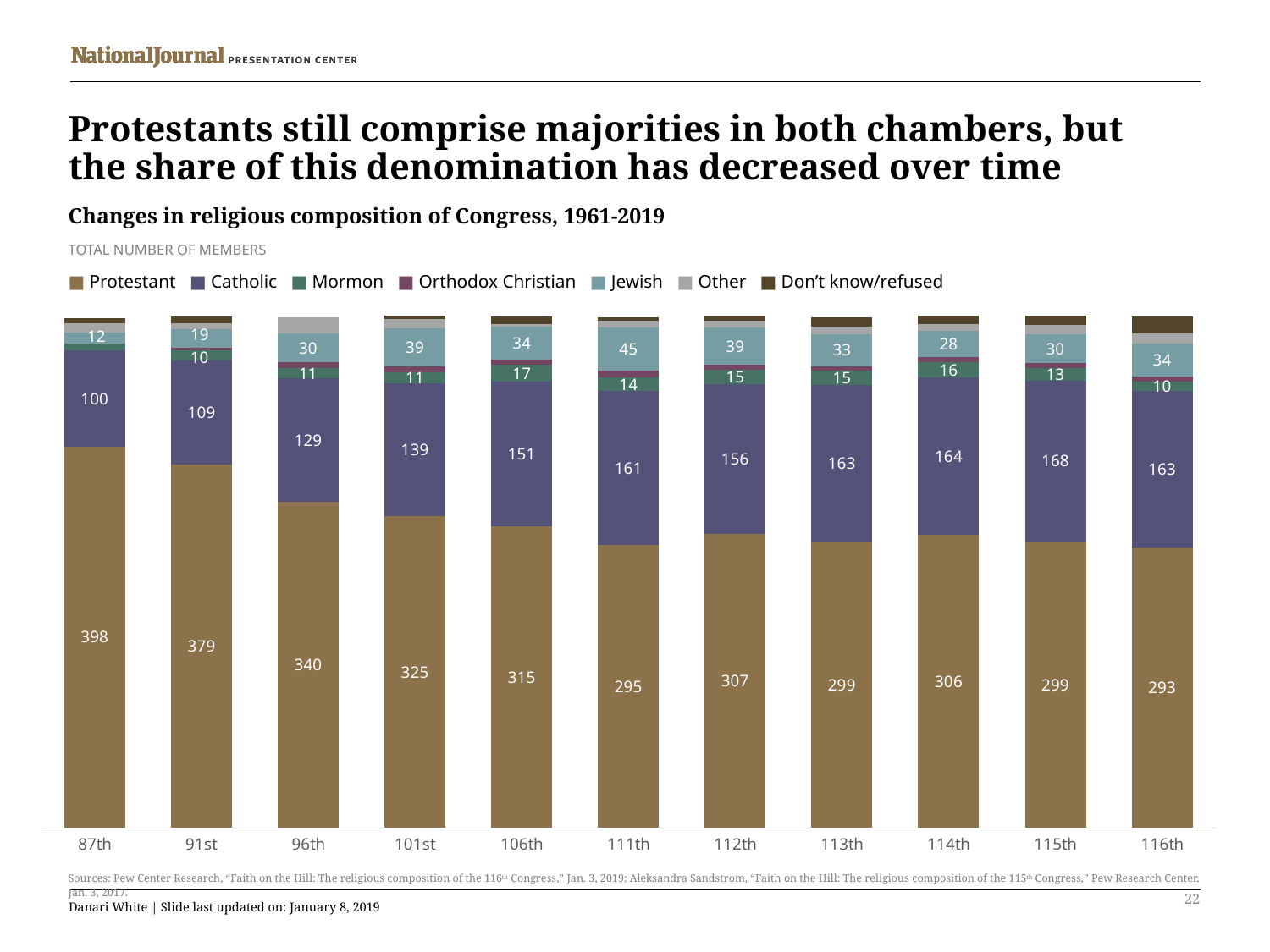
How many Congresses are shown along the x axis? 11 What kind of chart is shown on the slide? Stacked bar chart Does the number of Protestant members generally rise or fall from the 87th to the 116th Congress? Fall Which Congress has the highest number of Protestant members? 87th Which Congress has the lowest number of Catholic members? 87th What is the number of Jewish members in the 111th Congress? 45 What is the number of Catholic members in the 115th Congress? 168 What is the number of Protestant members in the 87th Congress? 398 How many series does the legend list? 7 What is the difference in Protestant members between the 87th and 116th Congress? 105 What is the number of Mormon members in the 106th Congress? 17 Which is larger: the number of Catholic members in the 114th Congress or in the 116th Congress? 114th